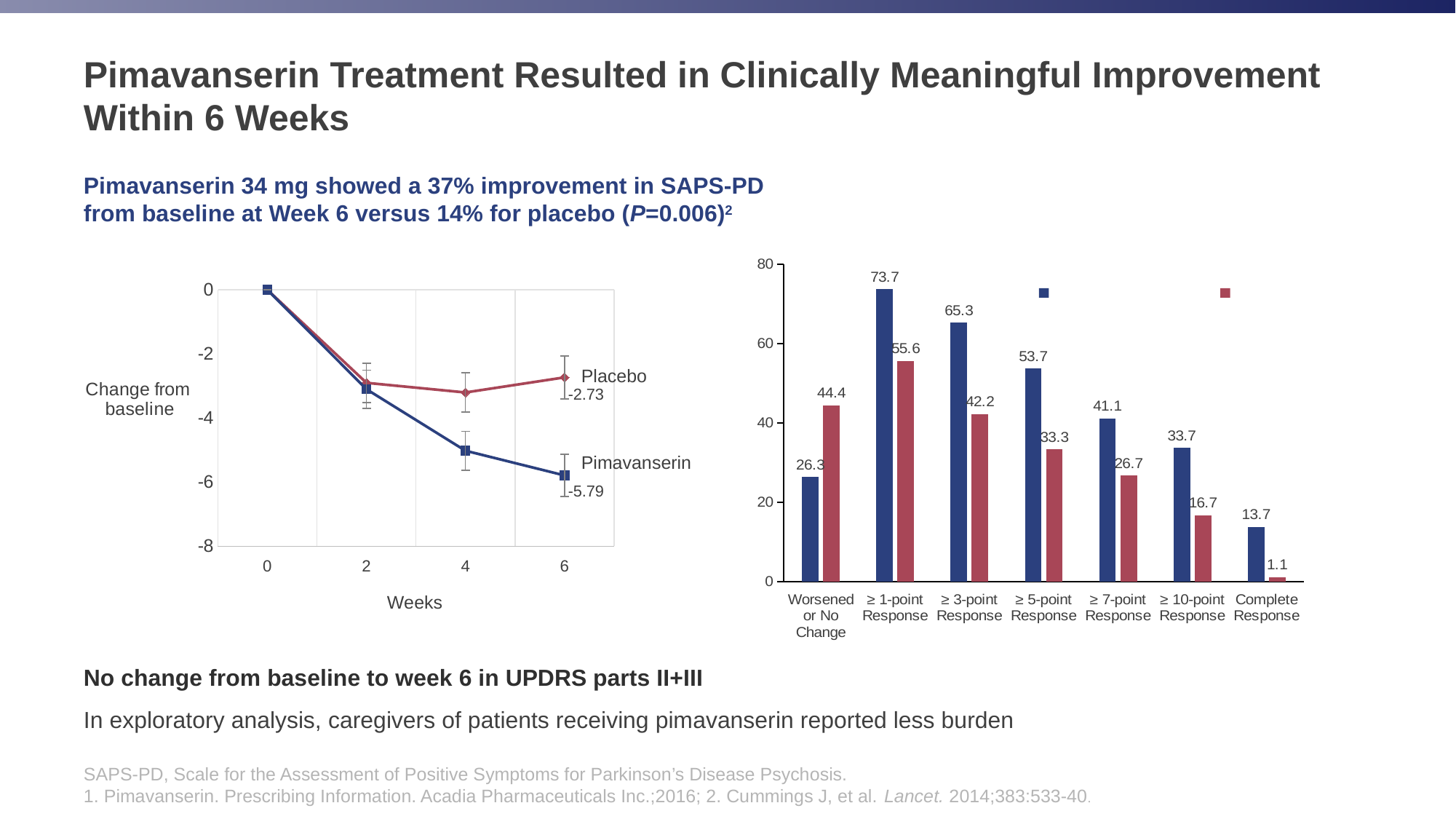
In the left chart, what is the change from baseline for Pimavanserin at week 6? -5.79 In the left chart, does the Pimavanserin line rise or fall from week 0 to week 6? fall In the right bar chart, what is the value of the blue bar for ≥ 1-point Response? 73.7 In the left chart, what is the difference between the Placebo and Pimavanserin values at week 6? 3.06 In the right bar chart, which category has the highest blue bar? ≥ 1-point Response In the left chart, what is the change from baseline for Placebo at week 6? -2.73 In the right bar chart, what is the value of the red bar for Complete Response? 1.1 How many categories are shown on the x axis of the right bar chart? 7 In the left chart, is the Pimavanserin value at week 4 greater or less than -4? less In the right bar chart, for Worsened or No Change, is the blue bar or the red bar larger? red bar What kind of chart is the chart on the left of the slide? line chart In the right bar chart, what is the difference between the blue and red bars for ≥ 5-point Response? 20.4